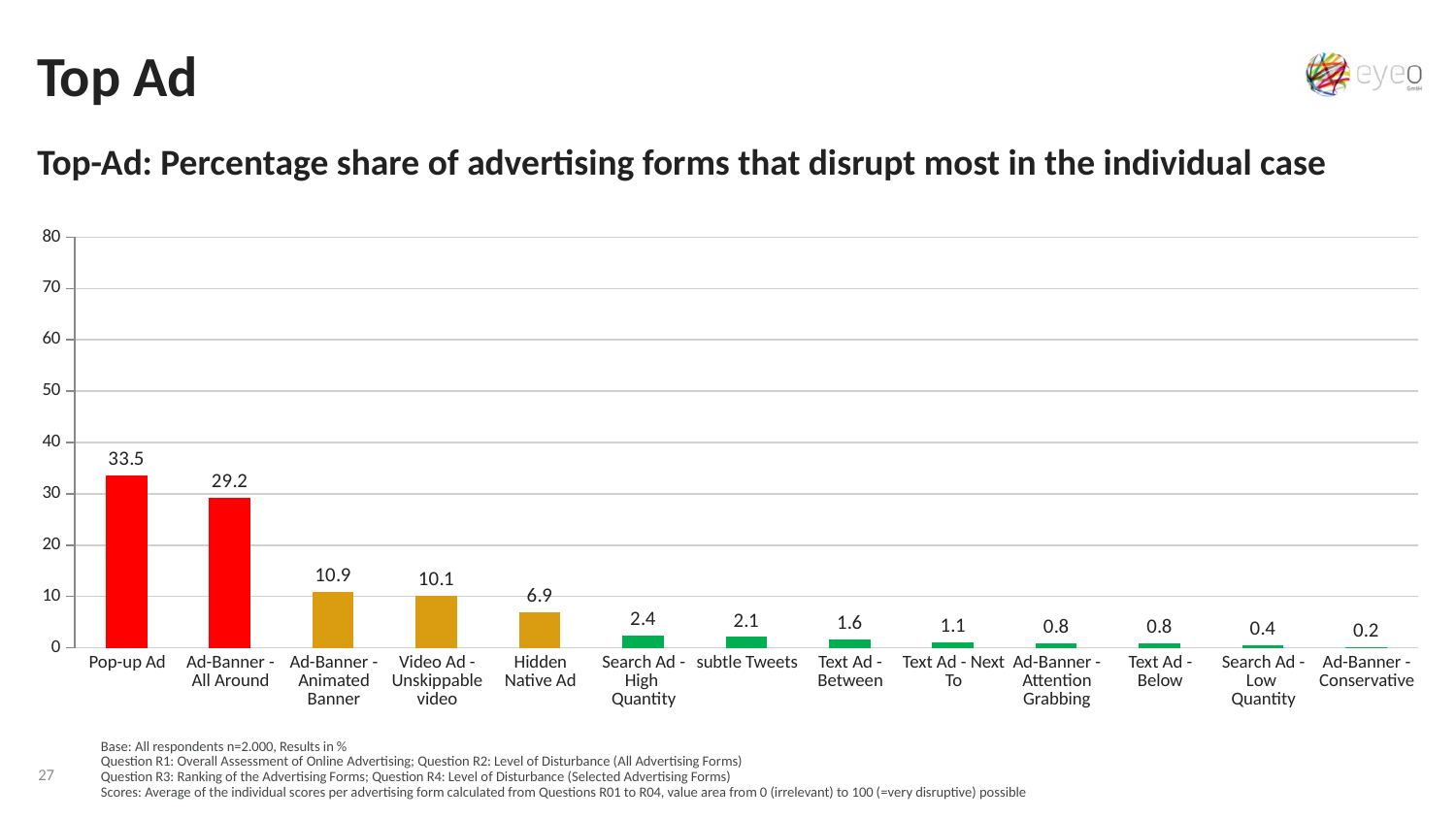
Which advertising form has the highest value? Pop-up Ad Which is larger, the value for Search Ad - High Quantity or the value for subtle Tweets? Search Ad - High Quantity What is the value for Hidden Native Ad? 6.9 What is the value for Pop-up Ad? 33.5 What is the difference between the values for Ad-Banner - Animated Banner and Video Ad - Unskippable video? 0.8 What is the value for Text Ad - Between? 1.6 Do the values rise or fall from left to right along the x axis? fall How many advertising forms are shown on the x axis? 13 Is the value for Ad-Banner - All Around greater or less than 20? greater What kind of chart is shown on the slide? bar chart What is the difference between the values for Pop-up Ad and Ad-Banner - All Around? 4.3 Which advertising form has the lowest value? Ad-Banner - Conservative